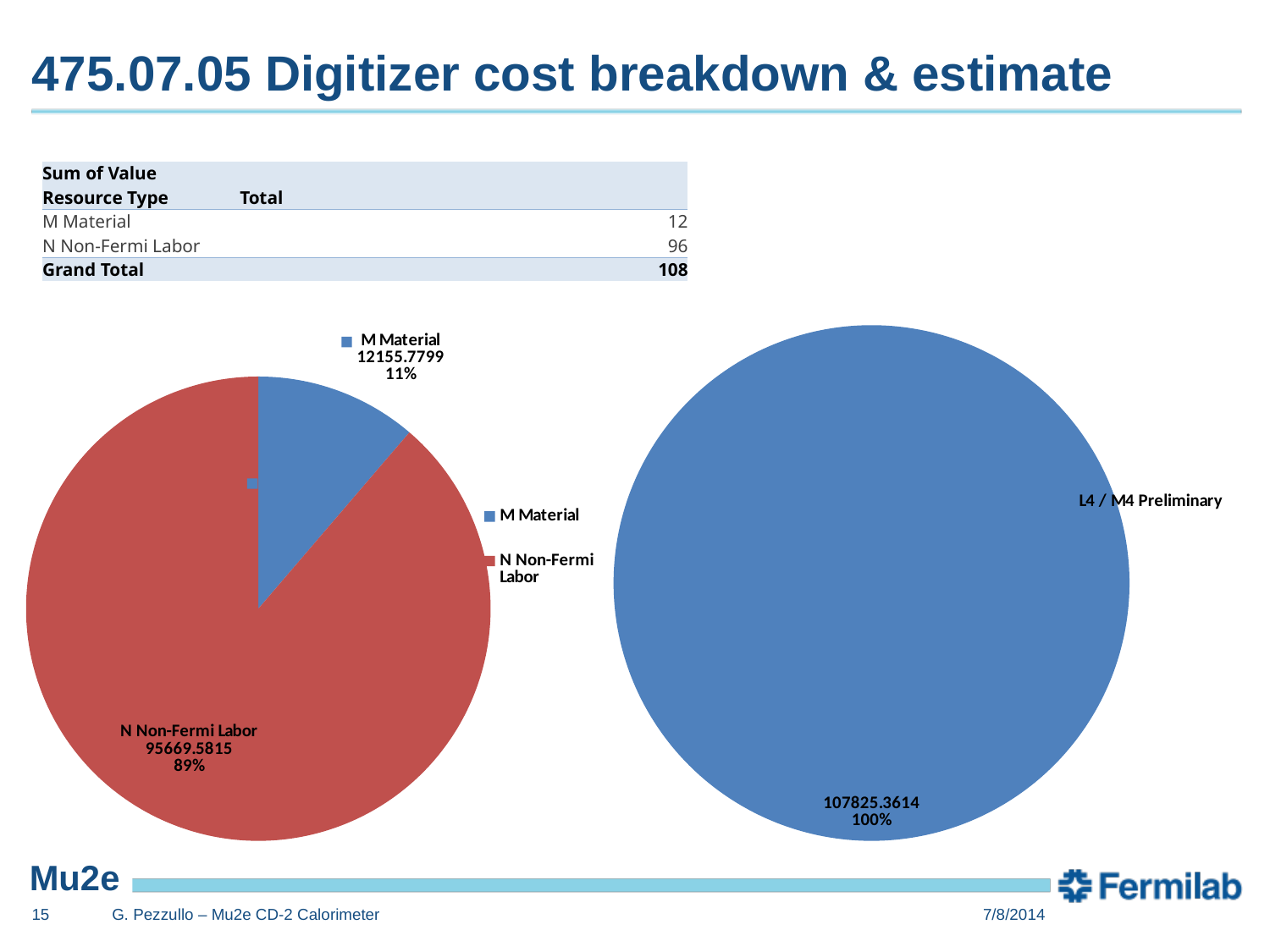
In the left pie chart, which is larger, M Material or N Non-Fermi Labor? N Non-Fermi Labor In the left pie chart, which category has the smallest slice? M Material In the left pie chart, what share of the pie does N Non-Fermi Labor represent? 89% In the left pie chart, which category has the largest slice? N Non-Fermi Labor In the left pie chart, what value is shown for N Non-Fermi Labor? 95669.5815 In the left pie chart, what value is shown for M Material? 12155.7799 In the left pie chart, what share of the pie does M Material represent? 11% In the right pie chart, what percentage is shown for the L4 / M4 Preliminary slice? 100% How many entries does the legend of the left pie chart list? 2 In the right pie chart, what value is shown for the L4 / M4 Preliminary slice? 107825.3614 How many slices does the left pie chart have? 2 What kind of chart is the left chart on the slide? pie chart